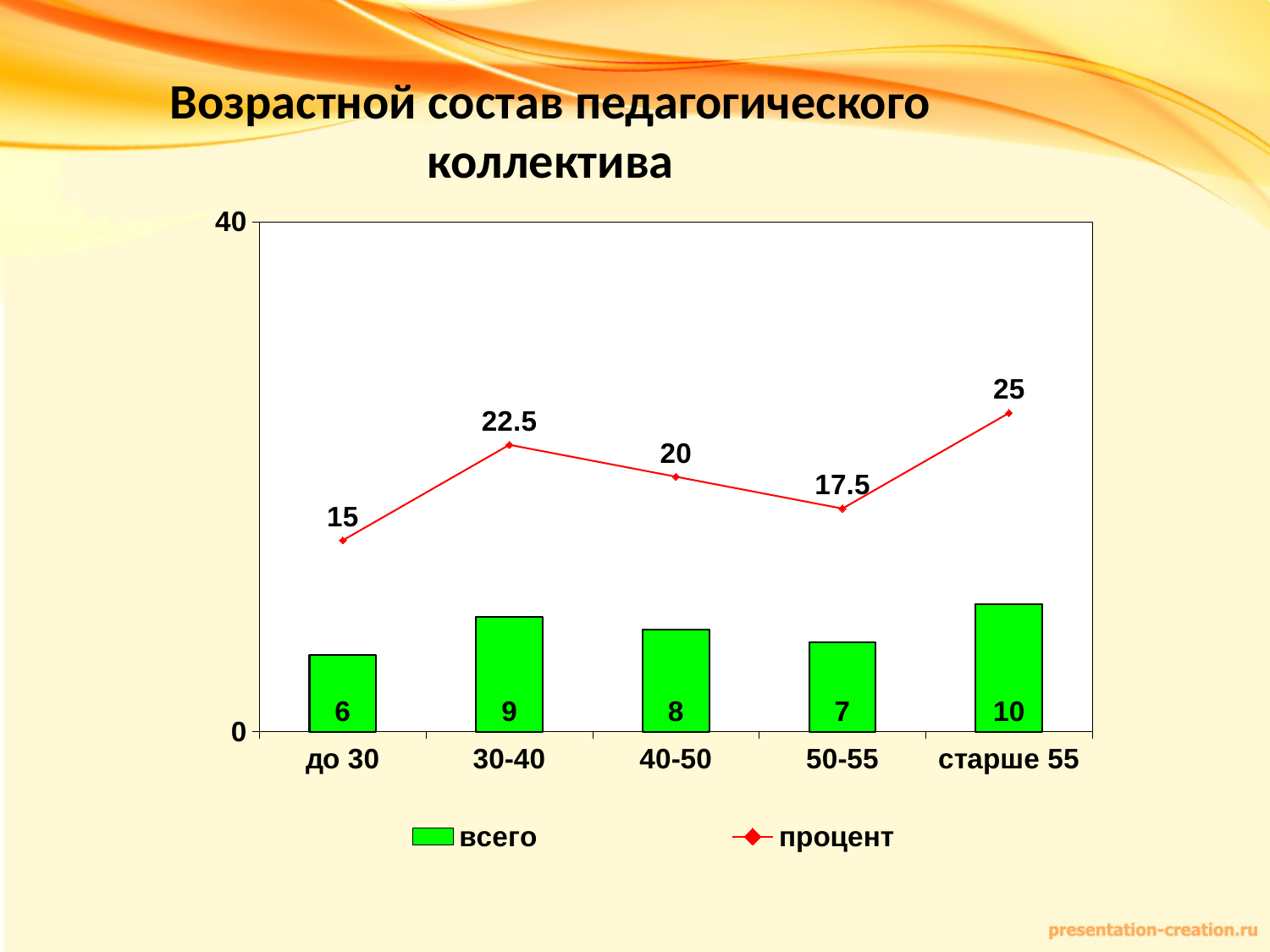
What is the value of the "процент" series for the "30-40" category? 22.5 What colour are the bars for the "всего" series? Green How many series does the legend list? 2 What is the value of the "всего" series for the "старше 55" category? 10 What kind of chart is shown on the slide? Combined bar and line chart What is the value of the "всего" series for the "до 30" category? 6 Which is larger in the "всего" series: "30-40" or "40-50"? 30-40 What is the difference between the "процент" values for "старше 55" and "50-55"? 7.5 Which category has the highest value in the "всего" series? старше 55 What is the title of the chart? Возрастной состав педагогического коллектива How many categories are shown on the x axis? 5 Which category has the lowest value in the "процент" series? до 30